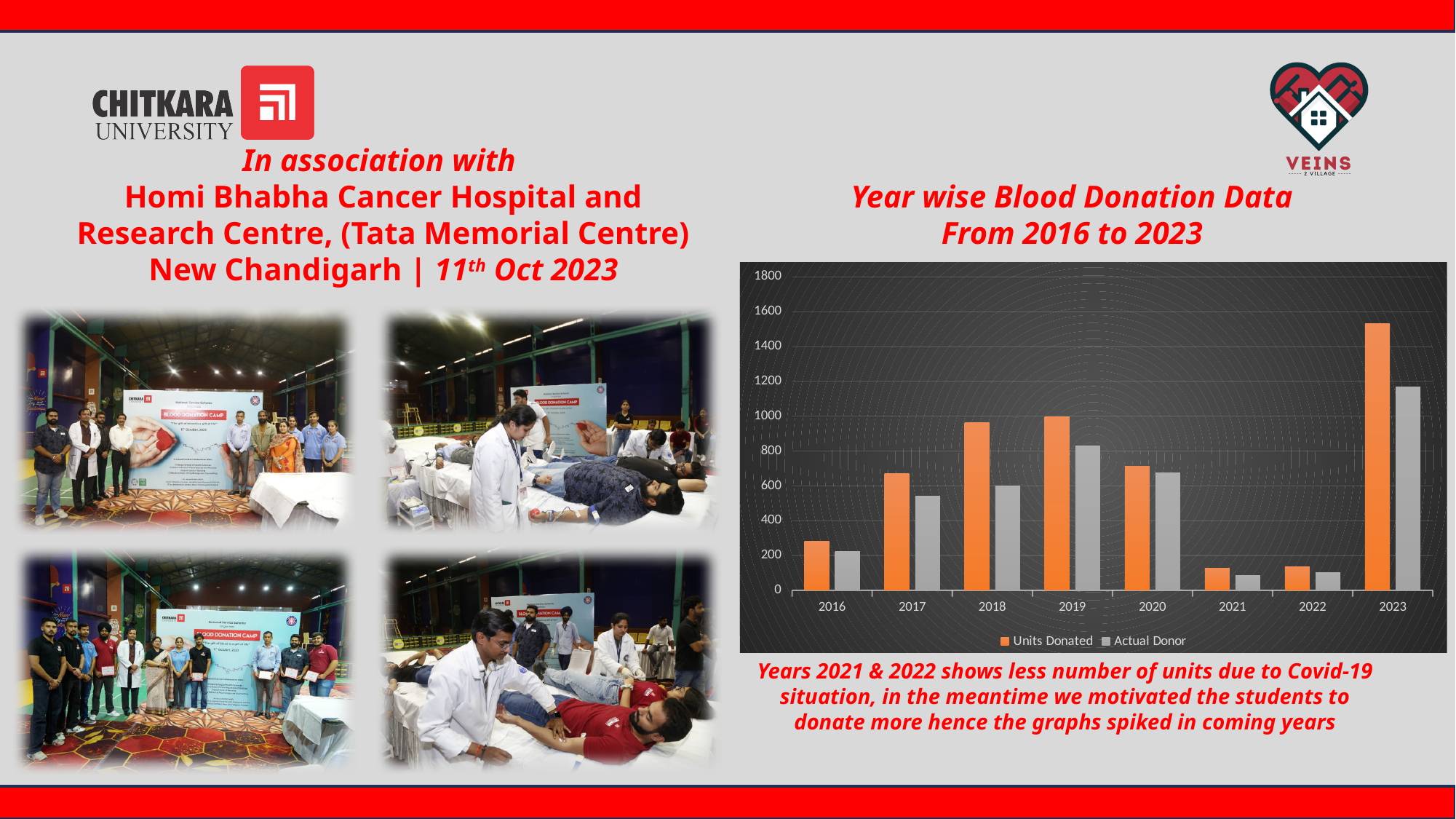
Which is larger, Units Donated in 2017 or Units Donated in 2018? 2018 Which year has the highest value for Actual Donor? 2023 How many series does the chart's legend list? 2 Which year has the highest value for Units Donated? 2023 How many years are shown on the x axis of the chart? 8 Is the value for Units Donated in 2023 greater or less than 1400? greater Which series is shown in orange in the chart? Units Donated Is the value for Actual Donor in 2019 greater or less than 600? greater In 2023, which is larger, Units Donated or Actual Donor? Units Donated Is the value for Actual Donor in 2023 greater or less than 1000? greater What kind of chart is shown on the slide? Bar chart